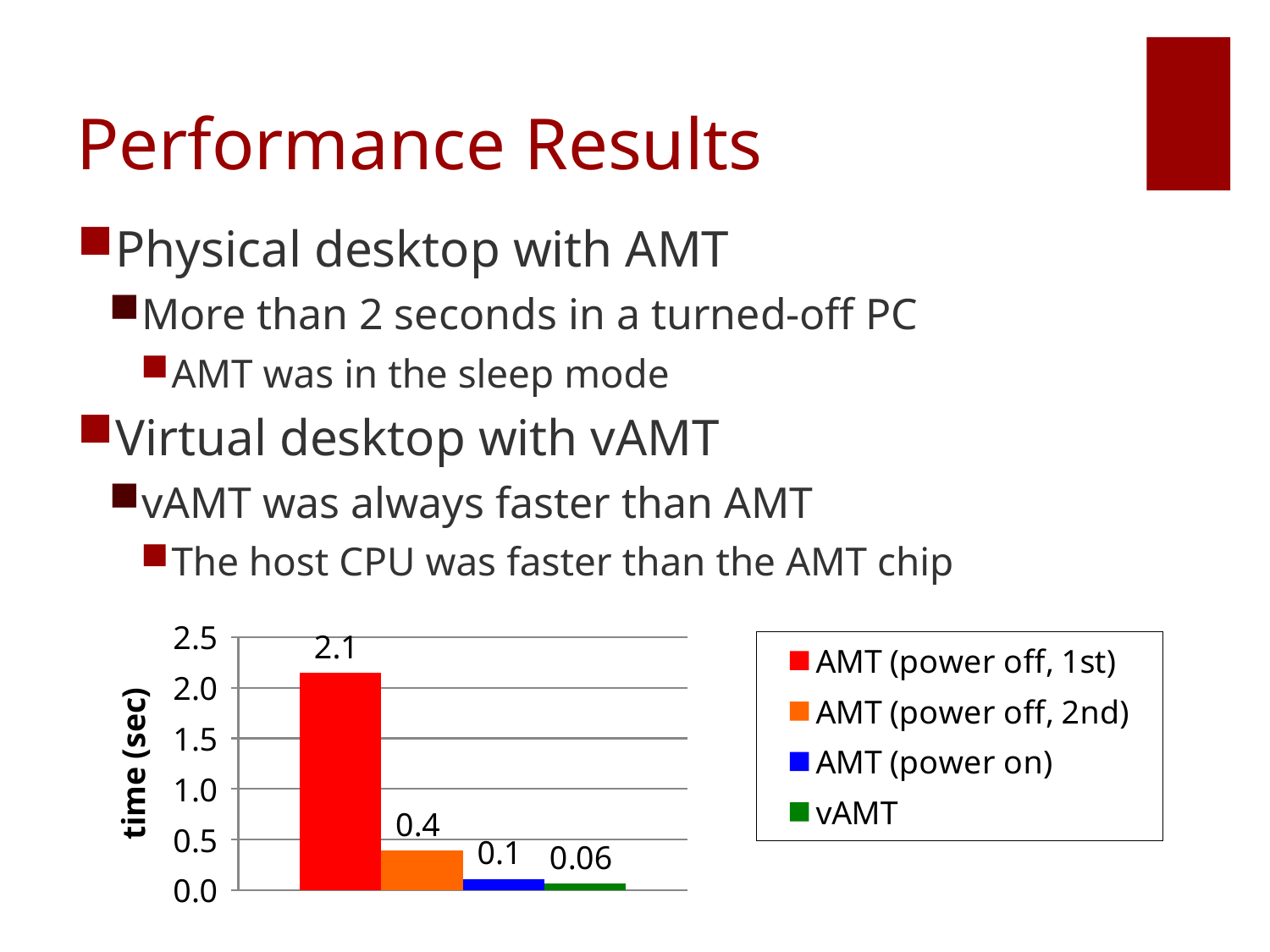
What is the value for AMT (power off, 1st)? 2.1 What kind of chart is shown on the slide? bar chart What is the value for AMT (power off, 2nd)? 0.4 What is the value for AMT (power on)? 0.1 Which is larger, the value for AMT (power on) or the value for vAMT? AMT (power on) Which series has the lowest value? vAMT What is the value for vAMT? 0.06 Is the value for AMT (power off, 1st) greater or less than 2.0? greater How many series does the legend list? 4 What is the difference between the values for AMT (power off, 1st) and AMT (power off, 2nd)? 1.7 Which series has the highest value? AMT (power off, 1st) What is the label of the vertical axis? time (sec)